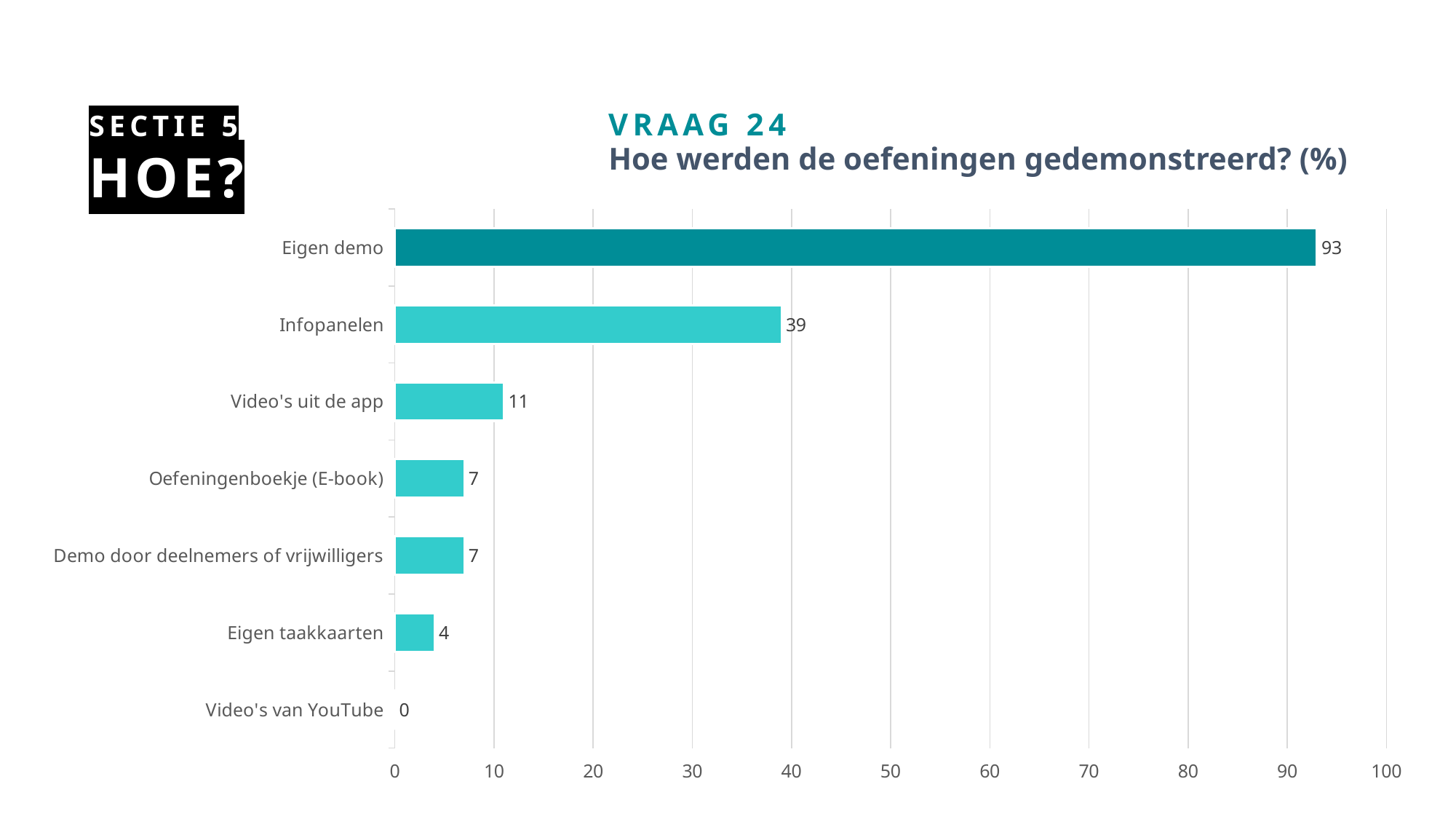
What is the value for Infopanelen? 39 Which category has the highest value? Eigen demo What is the difference between the values for Eigen demo and Infopanelen? 54 What is the title of the chart? Hoe werden de oefeningen gedemonstreerd? (%) What kind of chart is shown on the slide? bar chart What is the value for Eigen taakkaarten? 4 Is the value for Infopanelen greater or less than 50? less What is the value for Eigen demo? 93 Which category has the lowest value? Video's van YouTube Which is larger, the value for Video's uit de app or the value for Eigen taakkaarten? Video's uit de app How many categories are shown in the chart? 7 What is the value for Video's uit de app? 11